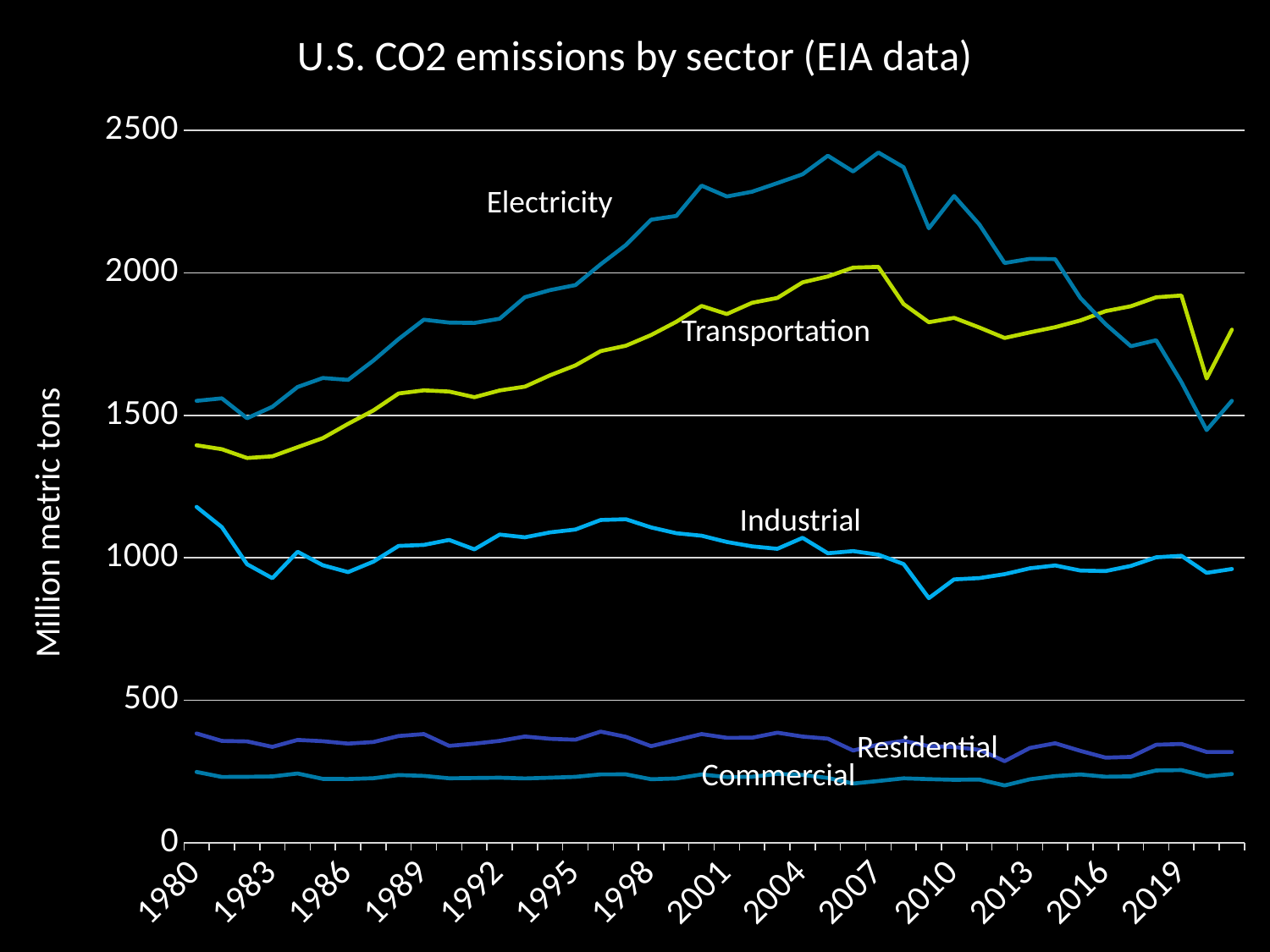
How many sectors (series) are plotted on the chart? 5 Is the value for Residential in 2019 greater or less than 500? less Do Electricity emissions rise or fall between 2007 and 2020? fall Which is larger in 2001, Electricity or Transportation? Electricity What is the title of the chart? U.S. CO2 emissions by sector (EIA data) Is the value for Industrial in 2009 greater or less than 1000? less Which sector has the lowest emissions across the chart? Commercial Is the value for Transportation in 1980 greater or less than 1500? less Which sector has the highest emissions in 2007? Electricity What kind of chart is shown on the slide? line chart Which is larger at the right end of the chart (2021), Electricity or Transportation? Transportation